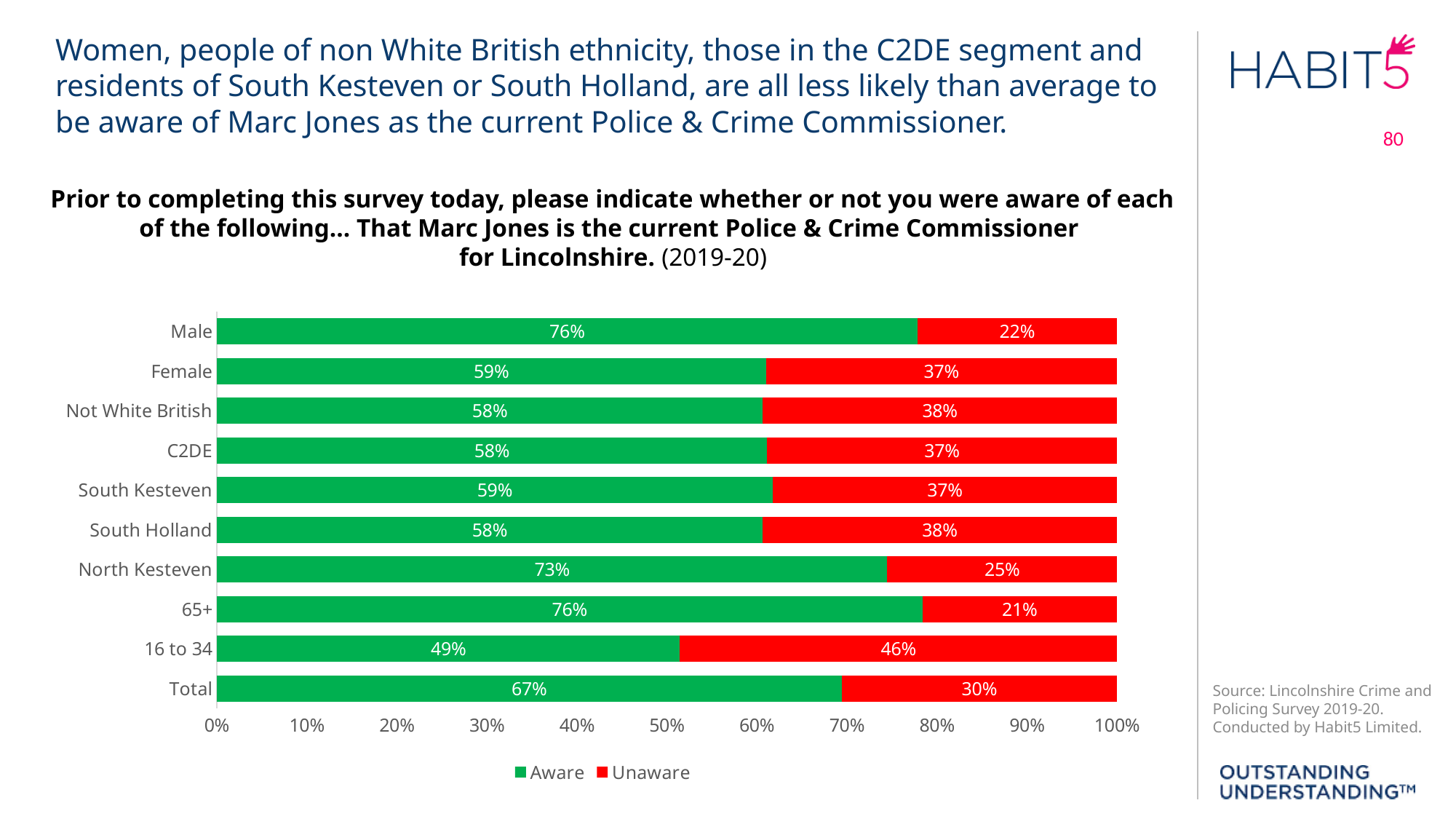
How many series does the legend list? 2 How many categories are shown on the chart? 10 What is the Unaware value for the 16 to 34 age group? 46% What is the difference in percentage points between the Aware value for Total and the Aware value for 16 to 34? 18 Which category has the highest Unaware value? 16 to 34 Which category has the lowest Aware value? 16 to 34 What percentage of Male respondents were aware that Marc Jones is the current Police & Crime Commissioner? 76% What is the Aware value for the Total category? 67% Which has a higher Aware value, North Kesteven or South Kesteven? North Kesteven Is the Aware value for Female greater or less than 50%? greater What is the Unaware value for North Kesteven? 25% What kind of chart is shown on the slide? Stacked bar chart